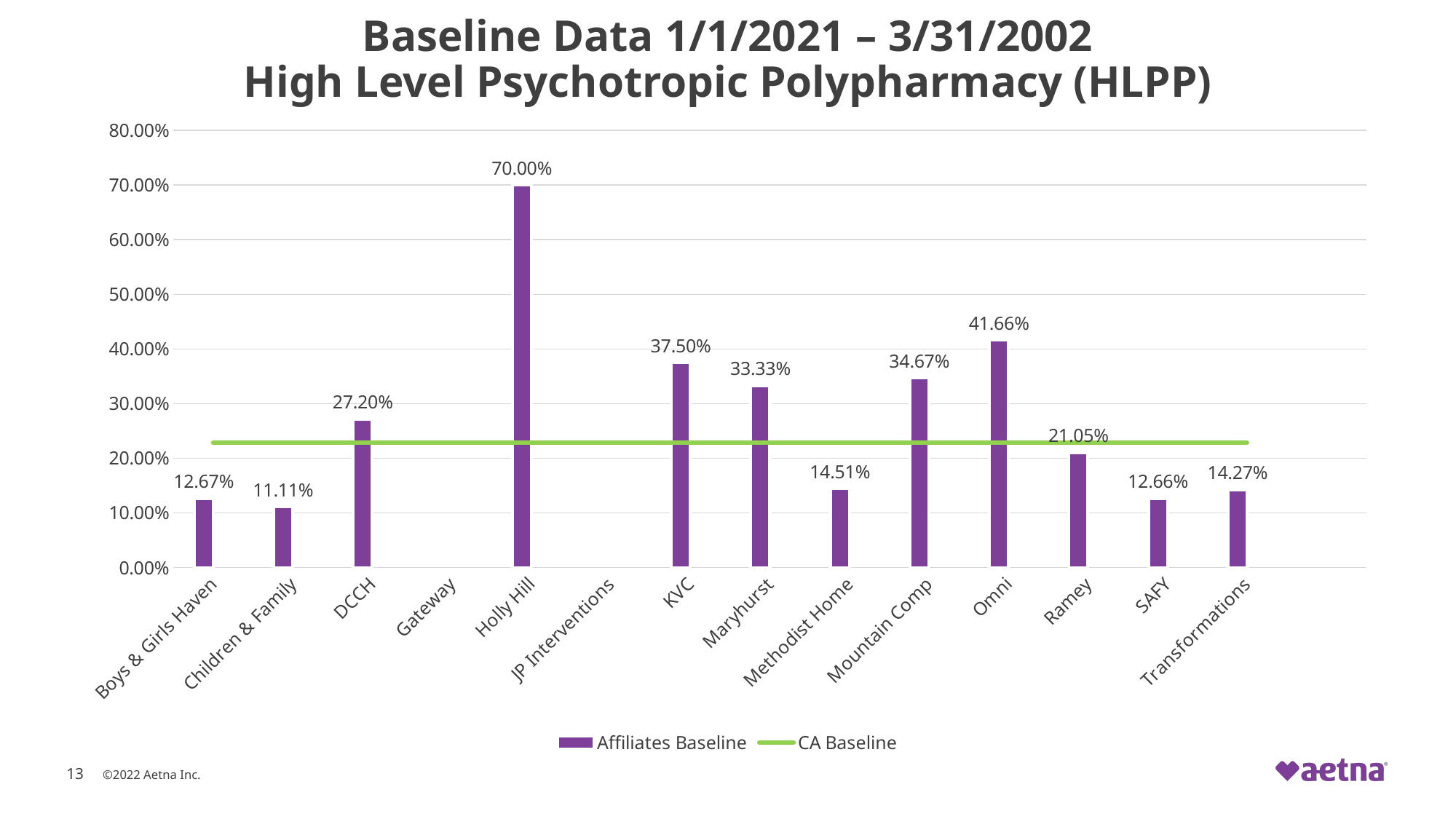
What is the Affiliates Baseline value for Methodist Home? 14.51% Which has a higher Affiliates Baseline value, KVC or Maryhurst? KVC Which affiliate has the highest Affiliates Baseline value? Holly Hill What is the Affiliates Baseline value for Ramey? 21.05% Is the CA Baseline line greater or less than 20.00%? greater What is the difference between the Affiliates Baseline values for Holly Hill and Omni? 28.34% What is the Affiliates Baseline value for Holly Hill? 70.00% How many affiliates are listed on the x axis? 14 What is the Affiliates Baseline value for Omni? 41.66% What kind of chart is shown on the slide? Combination bar and line chart How many series does the legend list? 2 Among the affiliates with a plotted bar, which has the lowest Affiliates Baseline value? Children & Family